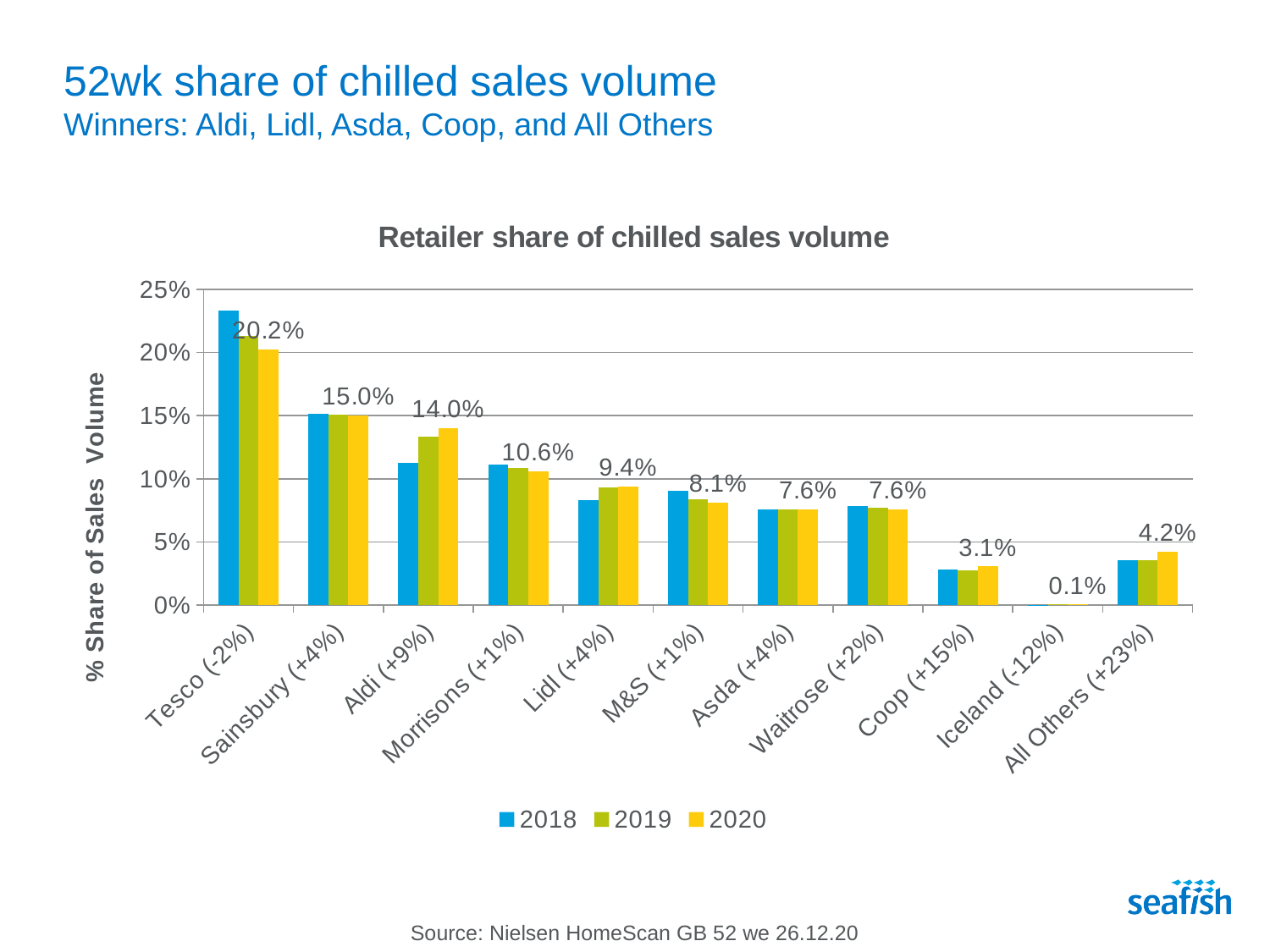
What is the 2020 value shown for Aldi (+9%)? 14.0% Do the bars for Tesco (-2%) rise or fall from 2018 to 2020? Fall What is the 2020 value shown for Coop (+15%)? 3.1% How many series does the legend list? 3 What is the 2020 share of chilled sales volume for Tesco (-2%)? 20.2% How many retailer categories are shown on the x axis? 11 What is the difference between the 2020 values for Tesco (-2%) and Sainsbury (+4%)? 5.2% Is the 2018 value for Tesco (-2%) greater or less than 20%? greater Which retailer has the highest 2020 share of chilled sales volume? Tesco (-2%) Which has a larger 2020 share, Lidl (+4%) or M&S (+1%)? Lidl (+4%) Which retailer has the lowest 2020 share of chilled sales volume? Iceland (-12%) What kind of chart is shown on the slide? Bar chart